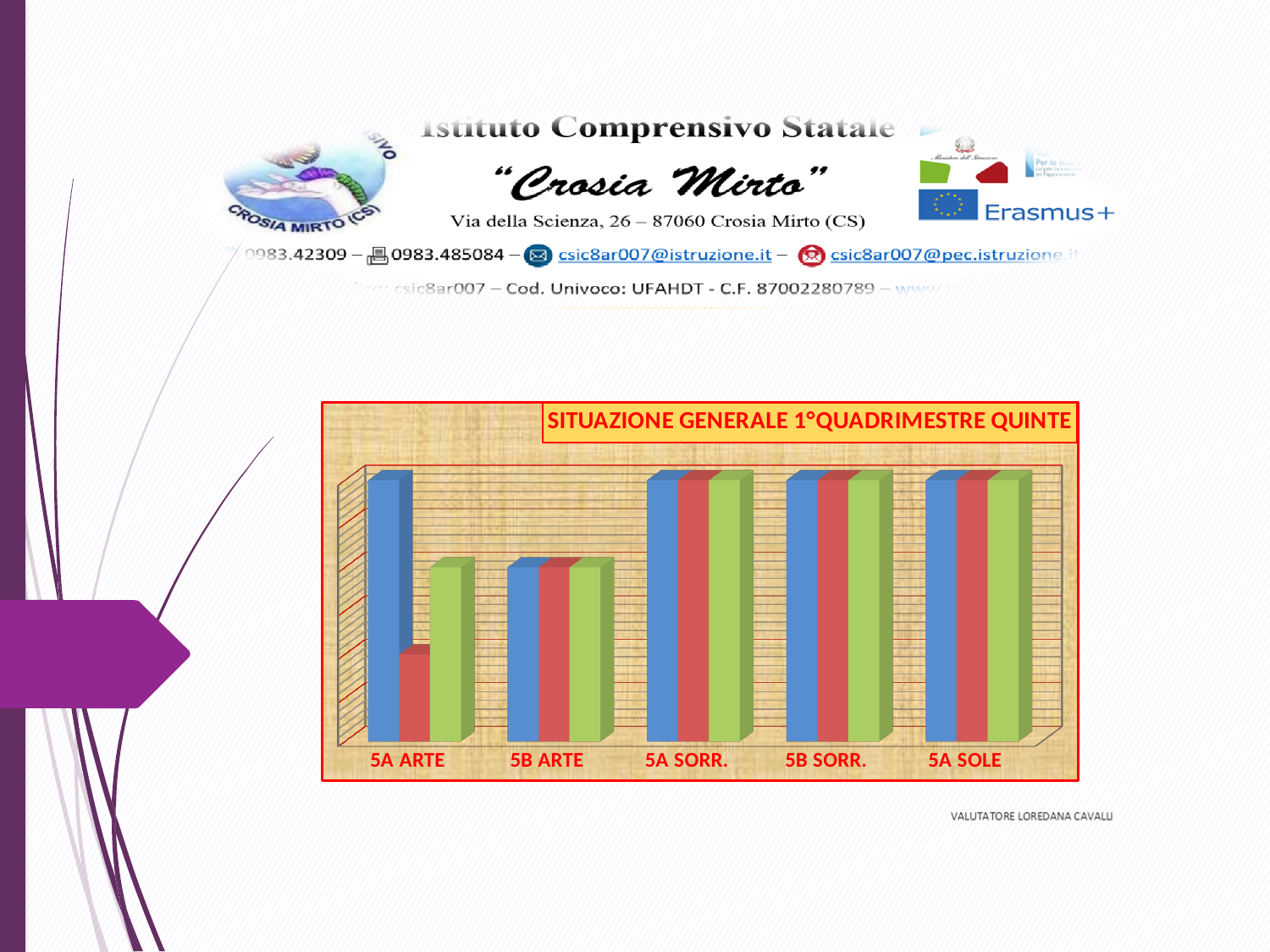
Is the blue bar for 5A ARTE taller or shorter than the blue bar for 5B ARTE? Taller For 5A ARTE, is the blue bar or the red bar taller? Blue Which category is the first one on the left of the chart? 5A ARTE Is the green bar for 5A SORR. taller or shorter than the green bar for 5B ARTE? Taller Which category has the shortest blue bar in the chart? 5B ARTE What is the title of the chart? SITUAZIONE GENERALE 1°QUADRIMESTRE QUINTE How many categories are shown along the x axis of the chart? 5 How many bars are plotted for each category in the chart? 3 What kind of chart is shown on the slide? Bar chart Which category has the shortest red bar in the chart? 5A ARTE